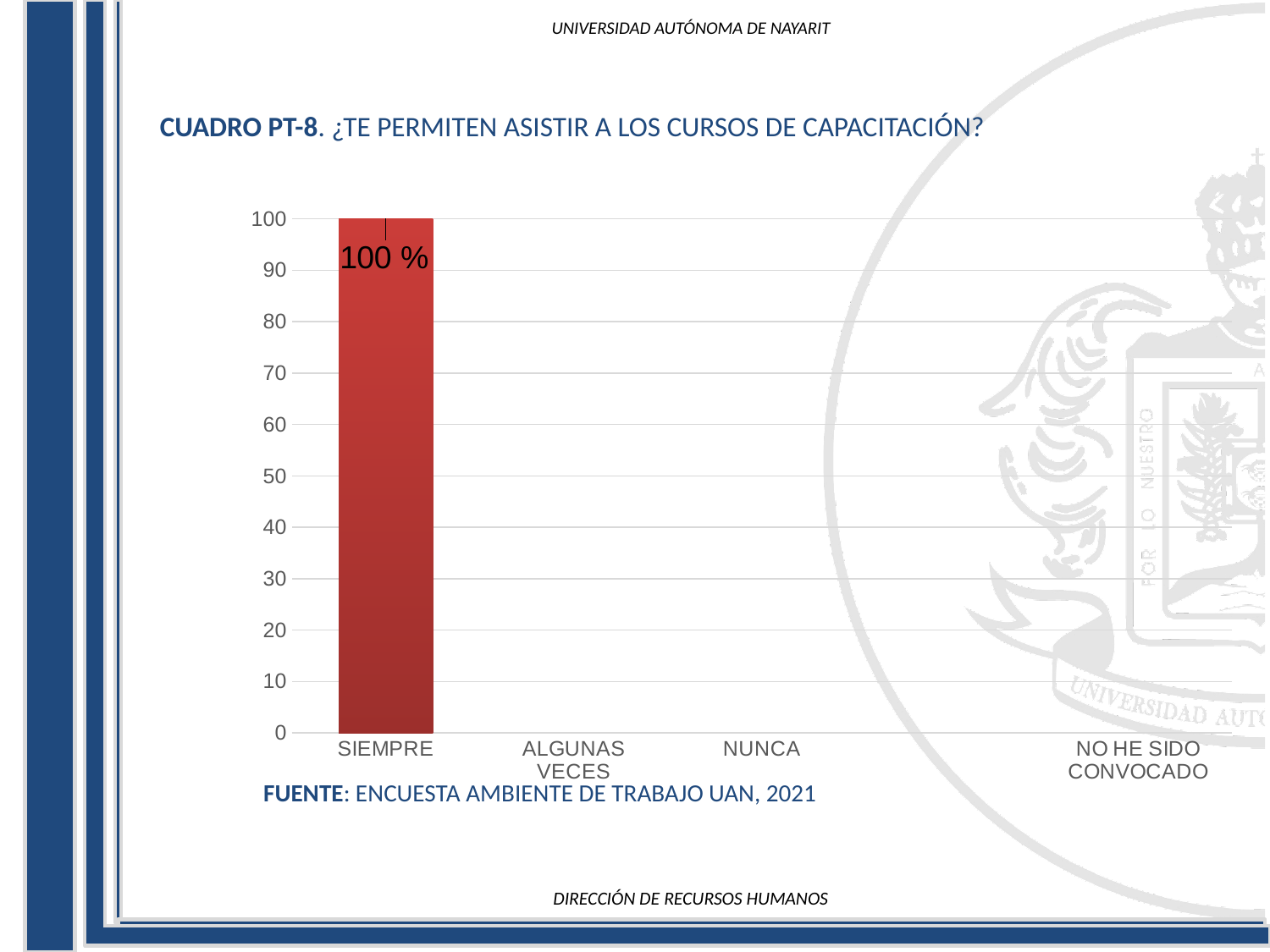
What is the label of the last category on the x axis? NO HE SIDO CONVOCADO Which category has the highest value? SIEMPRE What kind of chart is shown on the slide? bar chart How many categories are shown on the x axis? 4 Is the value for SIEMPRE greater or less than 50? greater What is the title of the chart (the question asked)? ¿TE PERMITEN ASISTIR A LOS CURSOS DE CAPACITACIÓN? What is the value shown for SIEMPRE? 100 % What is the highest value shown on the y axis? 100 Which is larger, the value for SIEMPRE or the value for NUNCA? SIEMPRE Which is larger, the value for SIEMPRE or the value for ALGUNAS VECES? SIEMPRE